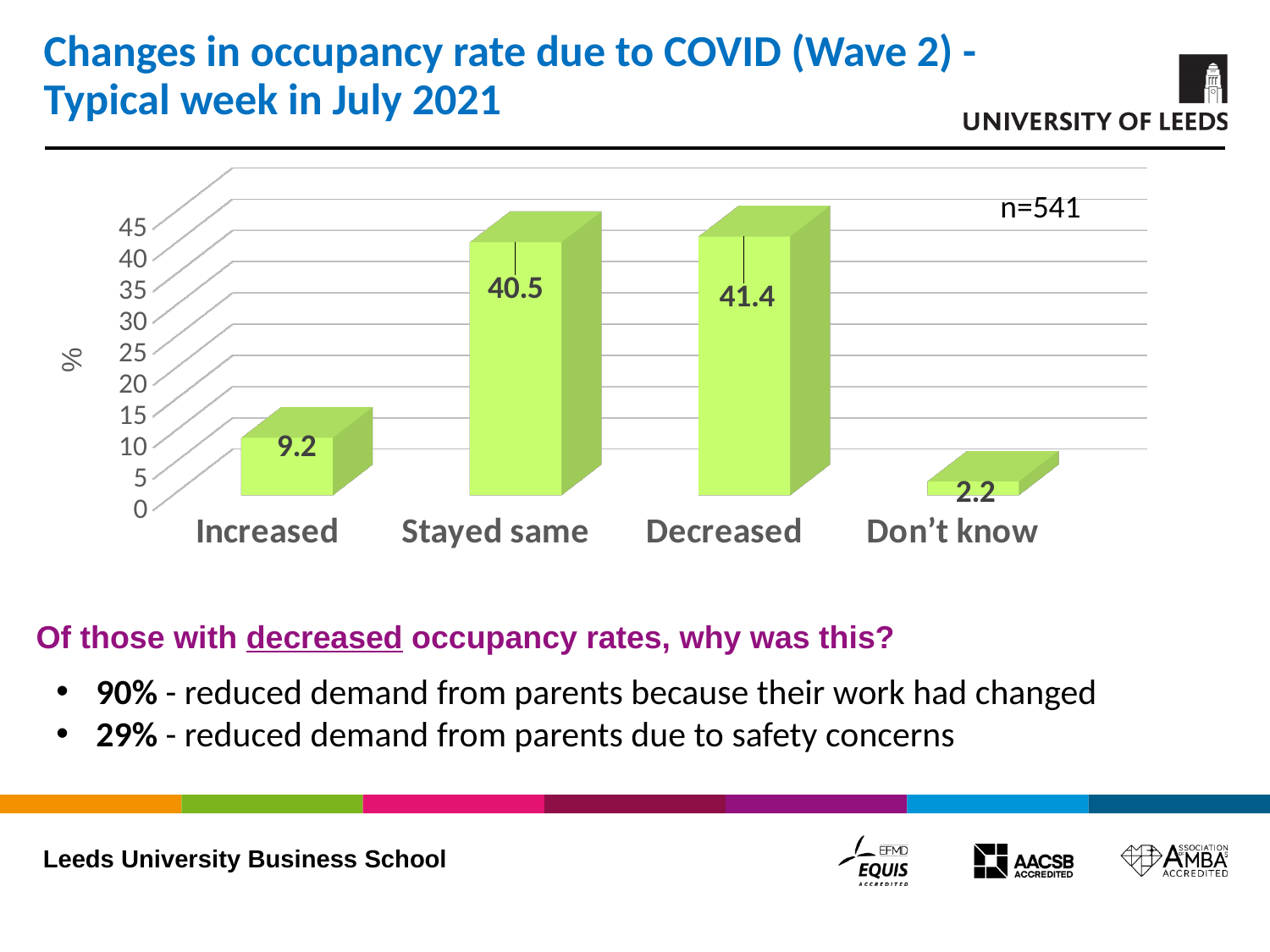
Which category has the highest value? Decreased What is the difference between the values for Increased and Don't know? 7.0 What is the value for Decreased? 41.4 Which is larger, the value for Increased or the value for Don't know? Increased What is the value for Don't know? 2.2 What is the value for Increased? 9.2 Which category has the lowest value? Don't know How many categories are shown on the x axis? 4 What is the difference between the values for Decreased and Stayed same? 0.9 What sample size (n) is shown on the chart? n=541 What kind of chart is shown on the slide? Bar chart What is the value for Stayed same? 40.5